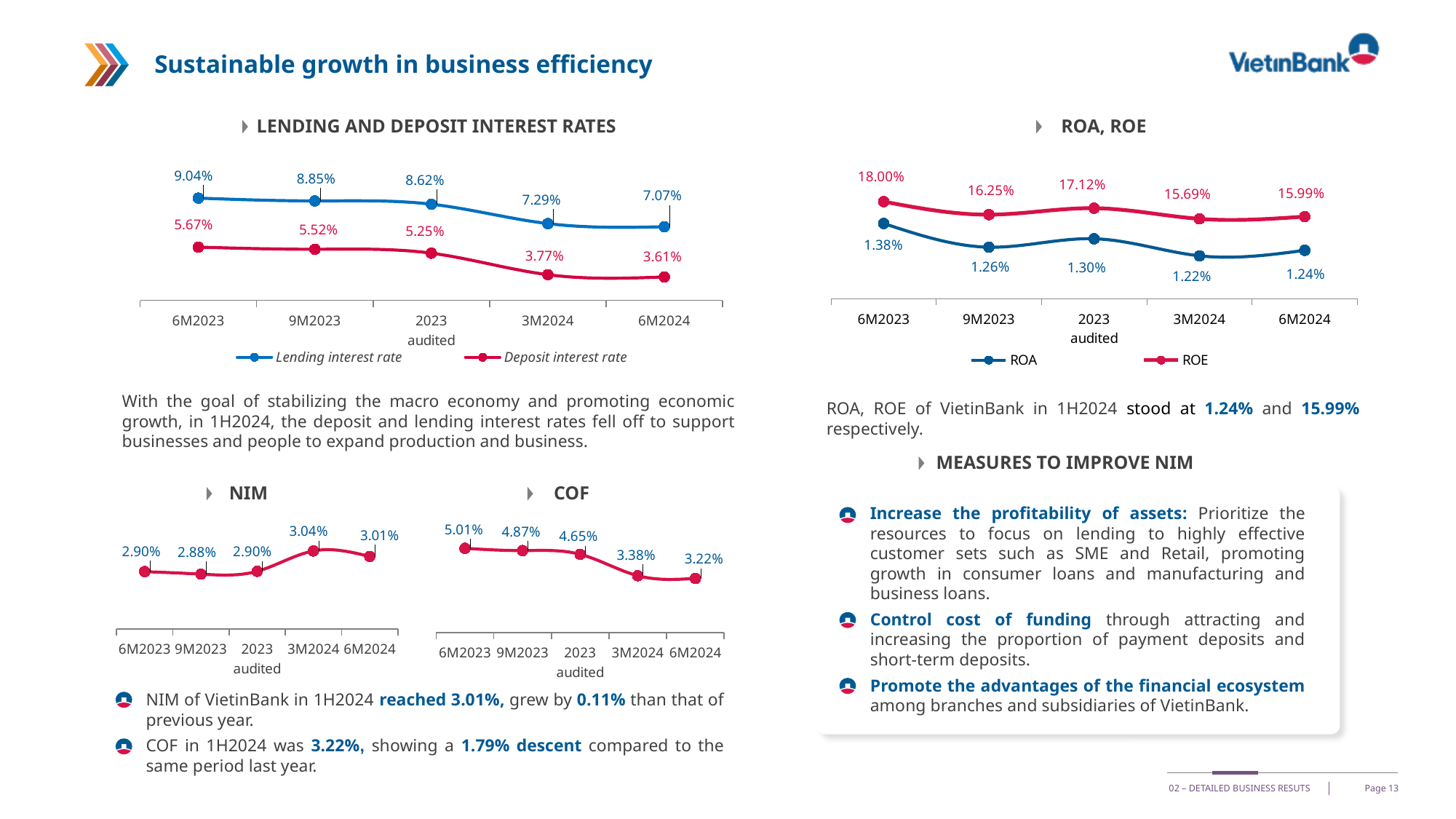
In the COF chart, what is the difference between the 6M2023 and 6M2024 values? 1.79% In the COF chart, do the values rise or fall from 6M2023 to 6M2024? Fall How many series does the legend of the LENDING AND DEPOSIT INTEREST RATES chart list? 2 In the LENDING AND DEPOSIT INTEREST RATES chart, what is the deposit interest rate at 3M2024? 3.77% In the ROA, ROE chart, which period has the highest ROE? 6M2023 In the LENDING AND DEPOSIT INTEREST RATES chart, what is the lending interest rate at 6M2023? 9.04% In the LENDING AND DEPOSIT INTEREST RATES chart, what is the difference between the lending and deposit interest rates at 6M2024? 3.46% What kind of chart is the ROA, ROE chart? Line chart How many data points are plotted in the NIM chart? 5 In the ROA, ROE chart, what is the ROE value for 2023 audited? 17.12% In the NIM chart, what is the value for 3M2024? 3.04% In the ROA, ROE chart, which period has the lowest ROA? 3M2024